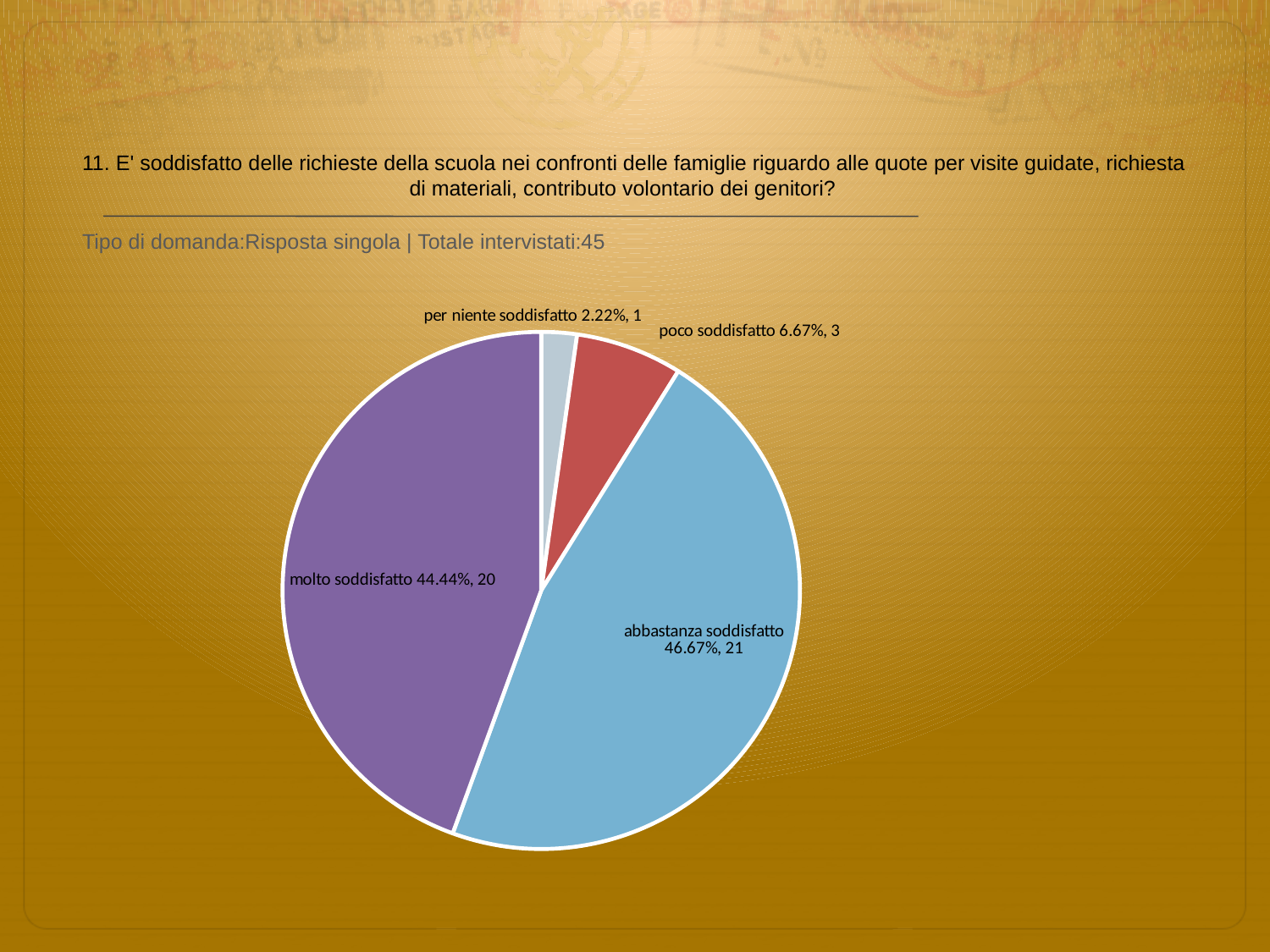
What kind of chart is shown on the slide? pie chart How many slices does the pie chart have? 4 How many respondents answered 'per niente soddisfatto'? 1 What percentage share does the 'poco soddisfatto' slice have? 6.67% How many respondents answered 'molto soddisfatto'? 20 What is the total number of respondents shown on the slide? 45 Which category has the smallest slice of the pie? per niente soddisfatto What colour is the 'molto soddisfatto' slice? purple What is the difference in respondent count between 'abbastanza soddisfatto' and 'molto soddisfatto'? 1 Which category has the largest slice of the pie? abbastanza soddisfatto What percentage share does the 'abbastanza soddisfatto' slice have? 46.67% Which has more respondents, 'poco soddisfatto' or 'per niente soddisfatto'? poco soddisfatto